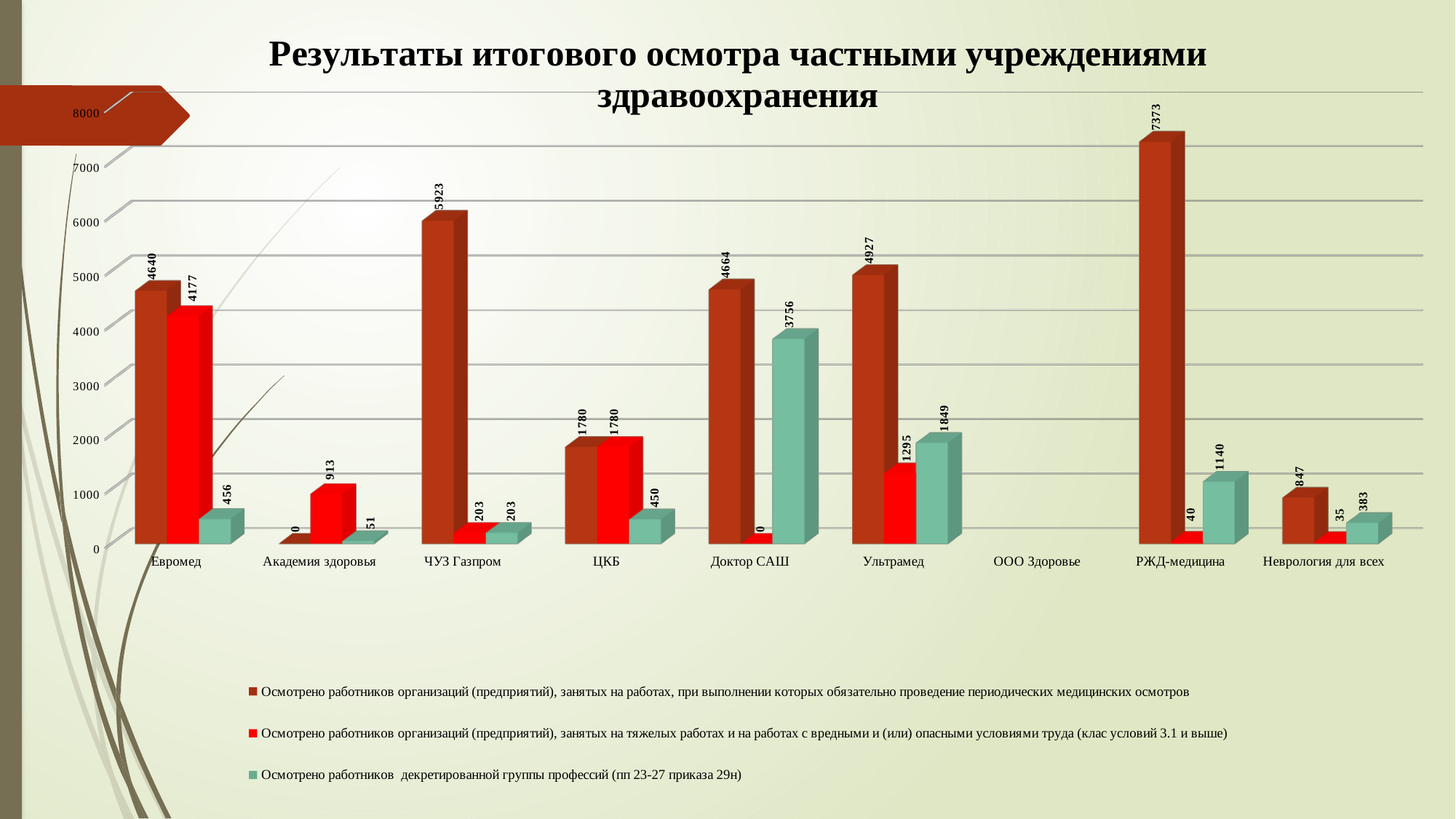
What kind of chart is shown on the slide? bar chart What is the value for Ультрамед in the series 'Осмотрено работников организаций (предприятий), занятых на тяжелых работах и на работах с вредными и (или) опасными условиями труда (клас условий 3.1 и выше)'? 1295 What is the difference between the values for РЖД-медицина (7373) and ЧУЗ Газпром (5923) in the series on periodic medical examinations? 1450 What is the title of the chart? Результаты итогового осмотра частными учреждениями здравоохранения Which institution has the highest value in the series 'Осмотрено работников декретированной группы профессий (пп 23-27 приказа 29н)'? Доктор САШ What is the value for Евромед in the series 'Осмотрено работников организаций (предприятий), занятых на работах, при выполнении которых обязательно проведение периодических медицинских осмотров'? 4640 Is the value for РЖД-медицина in the series on periodic medical examinations greater or less than 7000? greater Which is larger in the series on periodic medical examinations: the value for Ультрамед or the value for Доктор САШ? Ультрамед Which institution has the highest value in the series 'Осмотрено работников организаций (предприятий), занятых на работах, при выполнении которых обязательно проведение периодических медицинских осмотров'? РЖД-медицина How many institutions are listed on the x axis of the chart? 9 What is the value for Доктор САШ in the series 'Осмотрено работников декретированной группы профессий (пп 23-27 приказа 29н)'? 3756 How many series does the legend list? 3